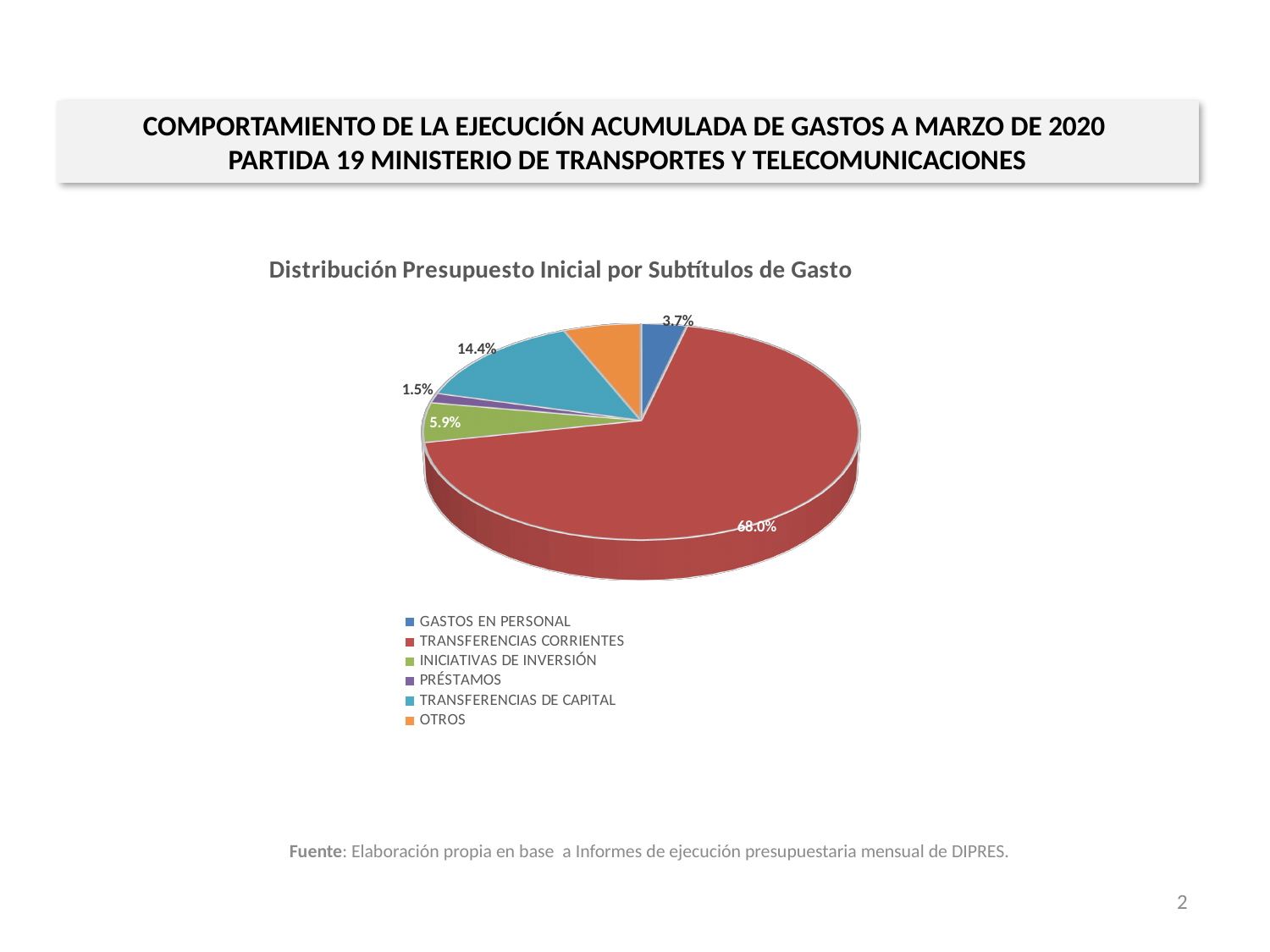
How many categories does the legend list? 6 Which category has the largest slice of the pie? TRANSFERENCIAS CORRIENTES What is the title of the chart? Distribución Presupuesto Inicial por Subtítulos de Gasto Which is larger, the share for INICIATIVAS DE INVERSIÓN or the share for GASTOS EN PERSONAL? INICIATIVAS DE INVERSIÓN What is the value shown for TRANSFERENCIAS DE CAPITAL? 14.4% What is the value shown for GASTOS EN PERSONAL? 3.7% What is the value shown for PRÉSTAMOS? 1.5% What kind of chart is shown on the slide? Pie chart Which category has the smallest slice of the pie? PRÉSTAMOS What is the difference between the shares of TRANSFERENCIAS CORRIENTES and TRANSFERENCIAS DE CAPITAL? 53.6% What is the value shown for INICIATIVAS DE INVERSIÓN? 5.9% What share of the pie does TRANSFERENCIAS CORRIENTES represent? 68.0%